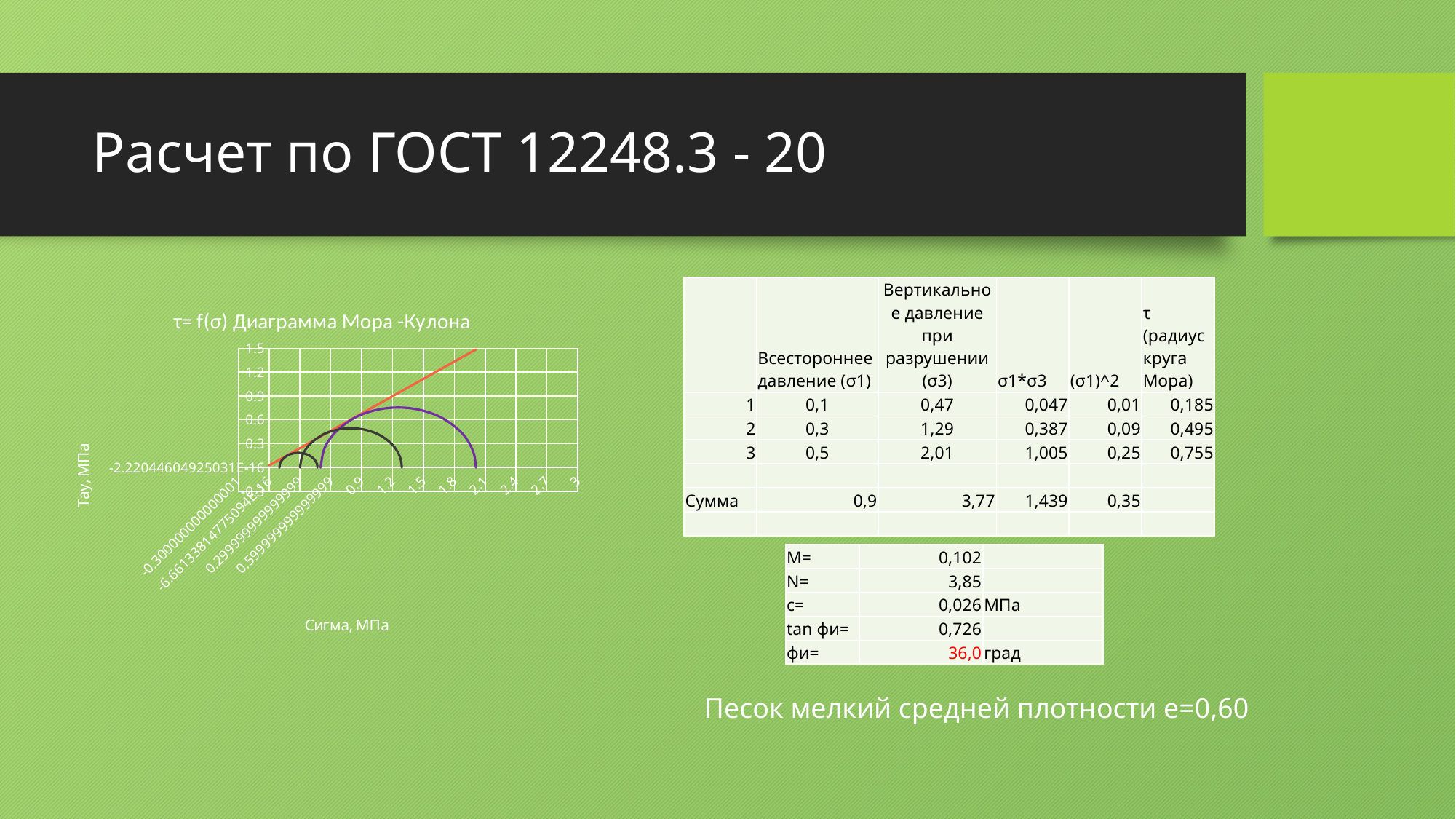
Which semicircle on the chart reaches the highest Tau value: the purple one or the black ones? the purple one What is the highest tick value shown on the horizontal axis of the chart? 3 Is the peak of the largest (purple) semicircle on the chart greater or less than 0.9? less What kind of chart is shown on the slide? line chart How many Mohr semicircles are plotted on the chart? 3 Is the highest point of the red line on the chart greater or less than 1.2? greater What is the highest tick value shown on the vertical axis of the chart? 1.5 What is the label of the vertical axis of the chart? Тау, МПа What is the title of the chart on the slide? τ= f(σ) Диаграмма Мора -Кулона Does the red straight line on the chart rise or fall as Sigma increases along the x axis? rise Is the peak of the smallest semicircle on the chart greater or less than 0.3? less